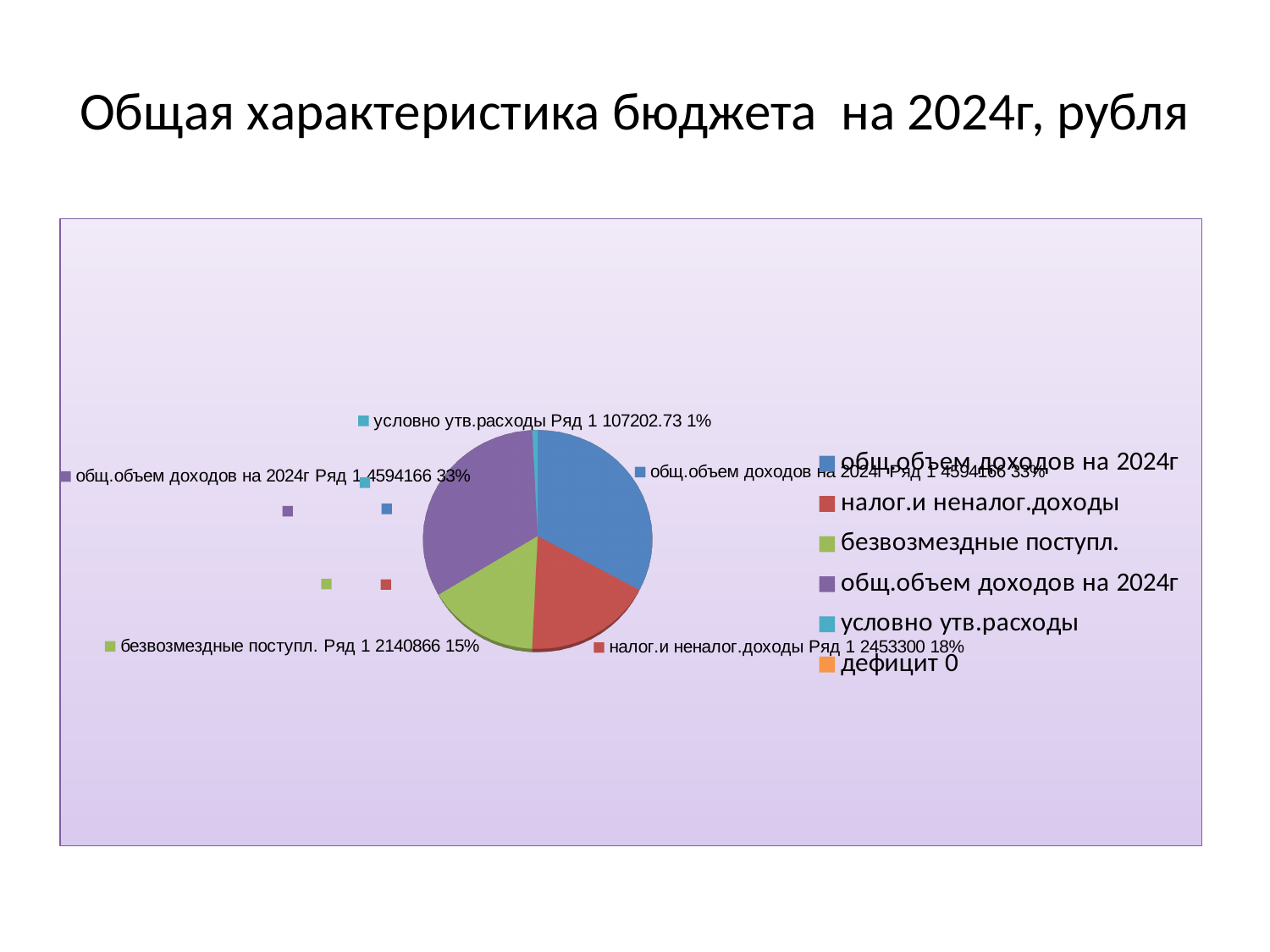
What kind of chart is shown on the slide? pie chart Which is larger, налог.и неналог.доходы or безвозмездные поступл.? налог.и неналог.доходы What share of the pie does налог.и неналог.доходы take? 18% What share of the pie does безвозмездные поступл. take? 15% What is the value shown for безвозмездные поступл.? 2140866 What is the title of the slide? Общая характеристика бюджета на 2024г, рубля How many entries does the chart legend list? 6 What share of the pie does условно утв.расходы take? 1% What is the value shown for общ.объем доходов на 2024г? 4594166 What is the value shown for условно утв.расходы? 107202.73 What is the value shown for налог.и неналог.доходы? 2453300 What is the difference between the values for налог.и неналог.доходы and безвозмездные поступл.? 312434